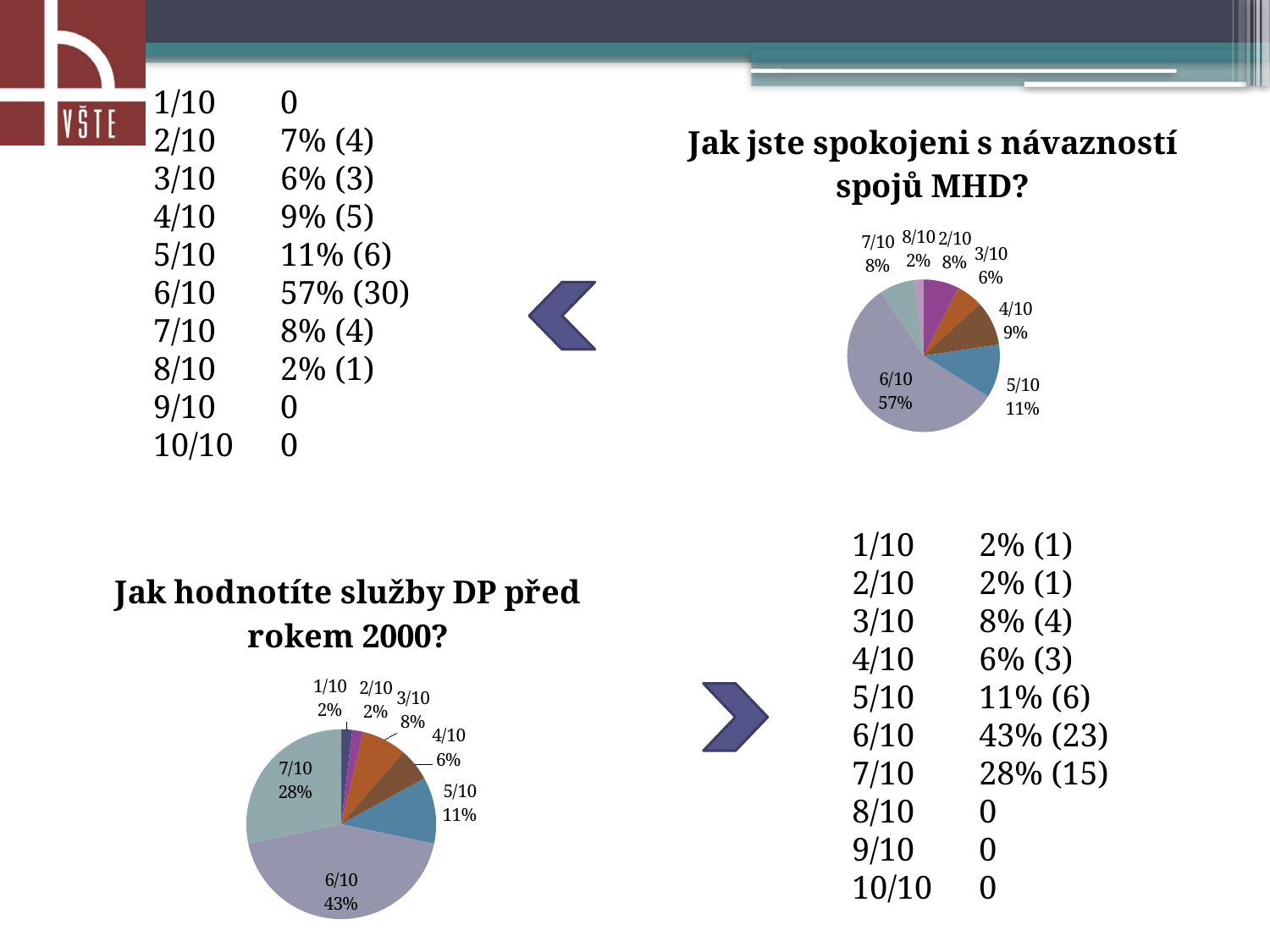
In the chart titled "Jak hodnotíte služby DP před rokem 2000?", which is larger, the 5/10 slice or the 4/10 slice? 5/10 In the chart titled "Jak jste spokojeni s návazností spojů MHD?", what is the difference between the 6/10 share and the 5/10 share? 46% In the chart titled "Jak hodnotíte služby DP před rokem 2000?", which category has the largest slice? 6/10 In the chart titled "Jak jste spokojeni s návazností spojů MHD?", what share does the 6/10 slice have? 57% In the chart titled "Jak jste spokojeni s návazností spojů MHD?", which category has the largest slice? 6/10 In the chart titled "Jak hodnotíte služby DP před rokem 2000?", what is the difference between the 6/10 share and the 7/10 share? 15% In the chart titled "Jak jste spokojeni s návazností spojů MHD?", which category has the smallest slice? 8/10 In the chart titled "Jak jste spokojeni s návazností spojů MHD?", what share does the 5/10 slice have? 11% What type of chart is used for "Jak hodnotíte služby DP před rokem 2000?"? Pie chart In the chart titled "Jak hodnotíte služby DP před rokem 2000?", what share does the 7/10 slice have? 28% In the chart titled "Jak hodnotíte služby DP před rokem 2000?", what share does the 3/10 slice have? 8% In the chart titled "Jak jste spokojeni s návazností spojů MHD?", how many slices does the pie have? 7